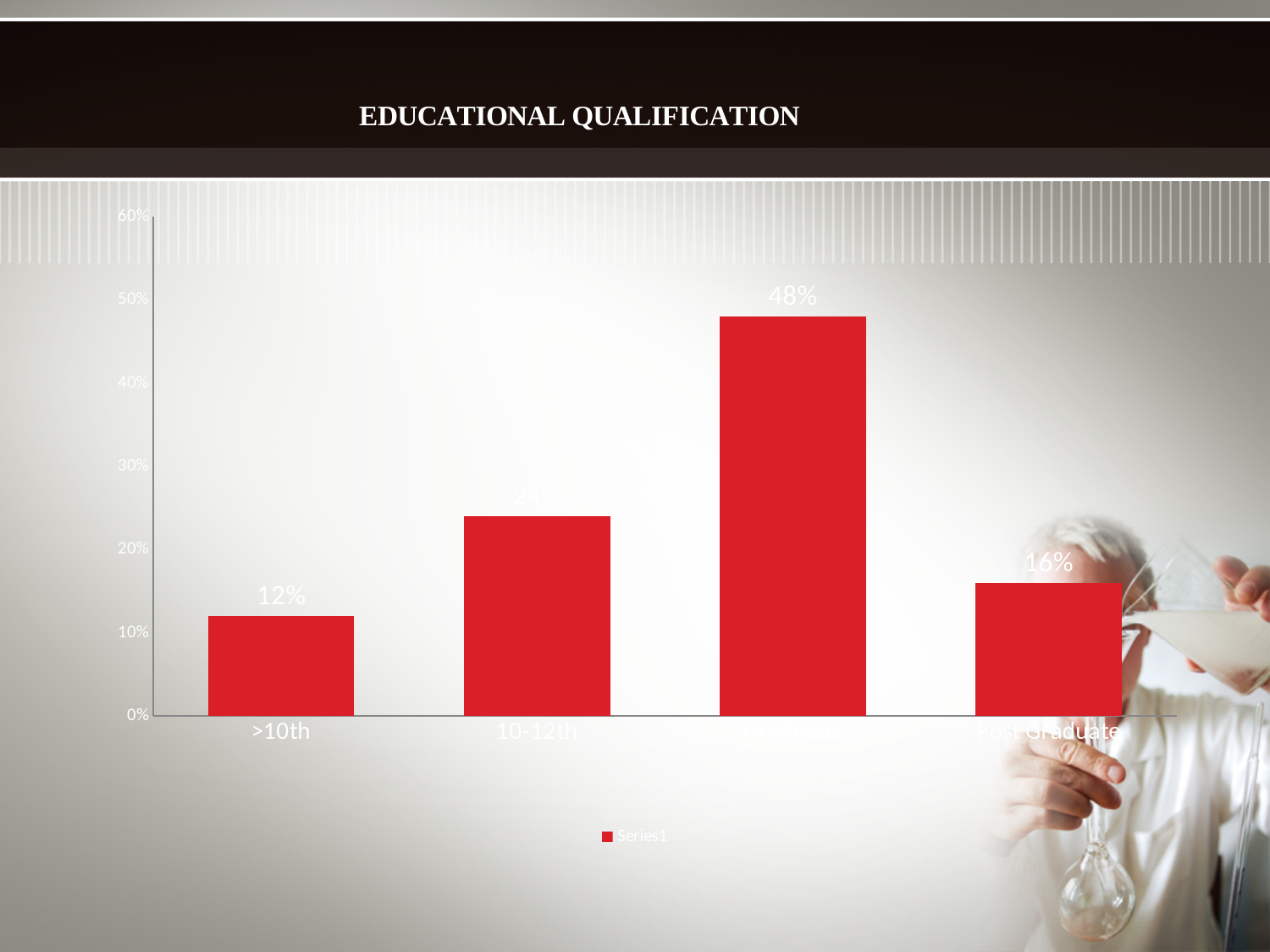
What is the difference between the values for Graduate and 10-12th? 24% Is the value for Graduate greater or less than 40%? greater What is the value for Post Graduate? 16% What is the value for Graduate? 48% What is the title of the chart? EDUCATIONAL QUALIFICATION What kind of chart is shown on the slide? bar chart How many categories are shown on the x axis? 4 Which category has the highest value? Graduate Which category has the lowest value? >10th What is the value for >10th? 12% What is the value for 10-12th? 24% Which is larger, the value for 10-12th or the value for Post Graduate? 10-12th